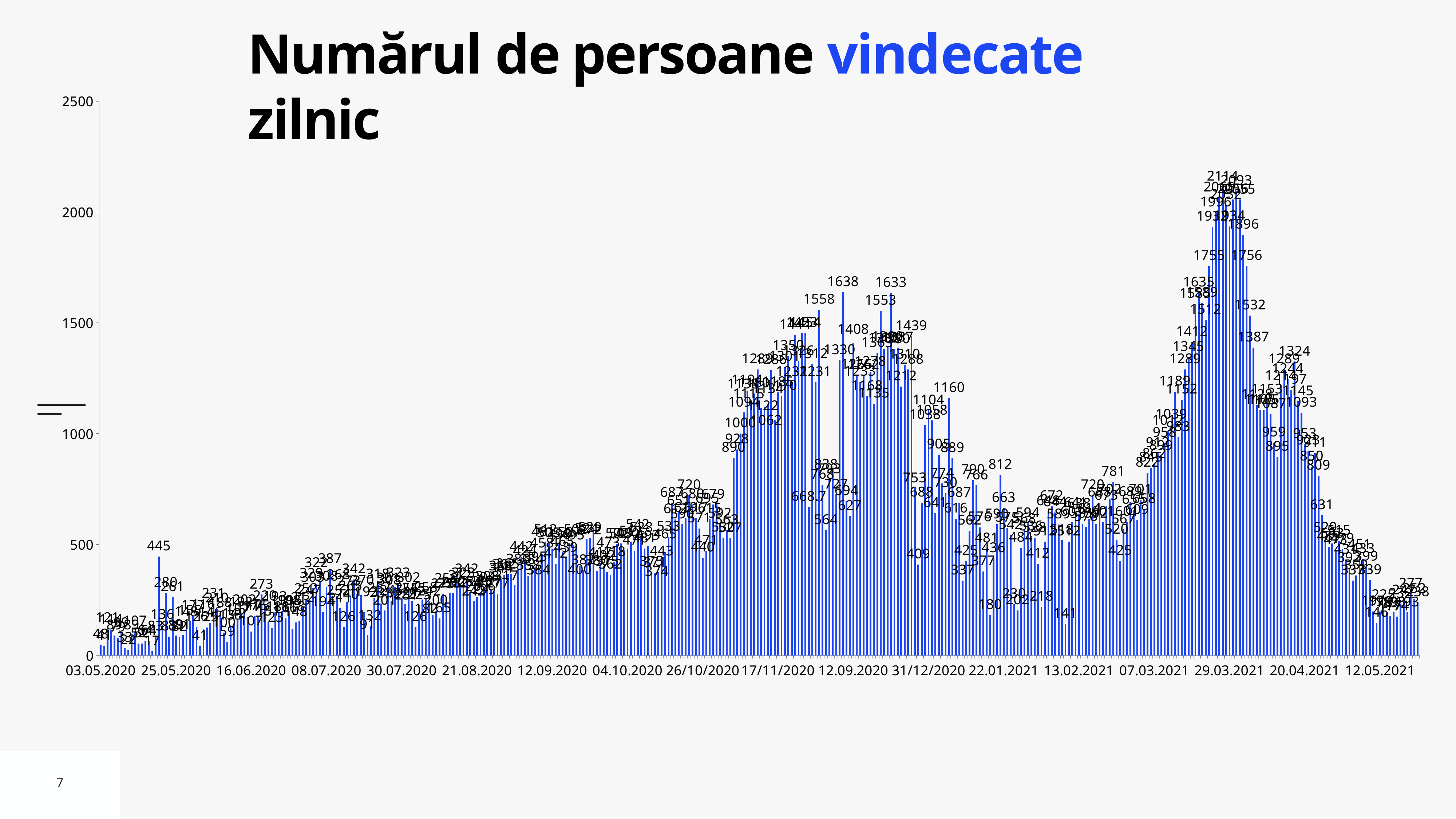
Do the values rise or fall between 29.03.2021 and 12.05.2021? fall Are the values around 17/11/2020 greater or less than 1000? greater What is the title of the chart? Numărul de persoane vindecate zilnic What kind of chart is shown on the slide? bar chart What is the value of the tallest bar in the first small peak near 25.05.2020? 445 Is the value for the first bar at 03.05.2020 greater or less than 500? less What is the highest data label shown on the chart? 2114 Is the value of the tallest bar near 29.03.2021 greater or less than 2000? greater What is the value of the tallest bar in the wave between 17/11/2020 and 31/12/2020? 1638 Do the values rise or fall between 07.03.2021 and 29.03.2021? rise What is the highest tick value shown on the vertical axis? 2500 What is the difference between the overall peak value (2114) and the peak of the late-2020 wave (1638)? 476